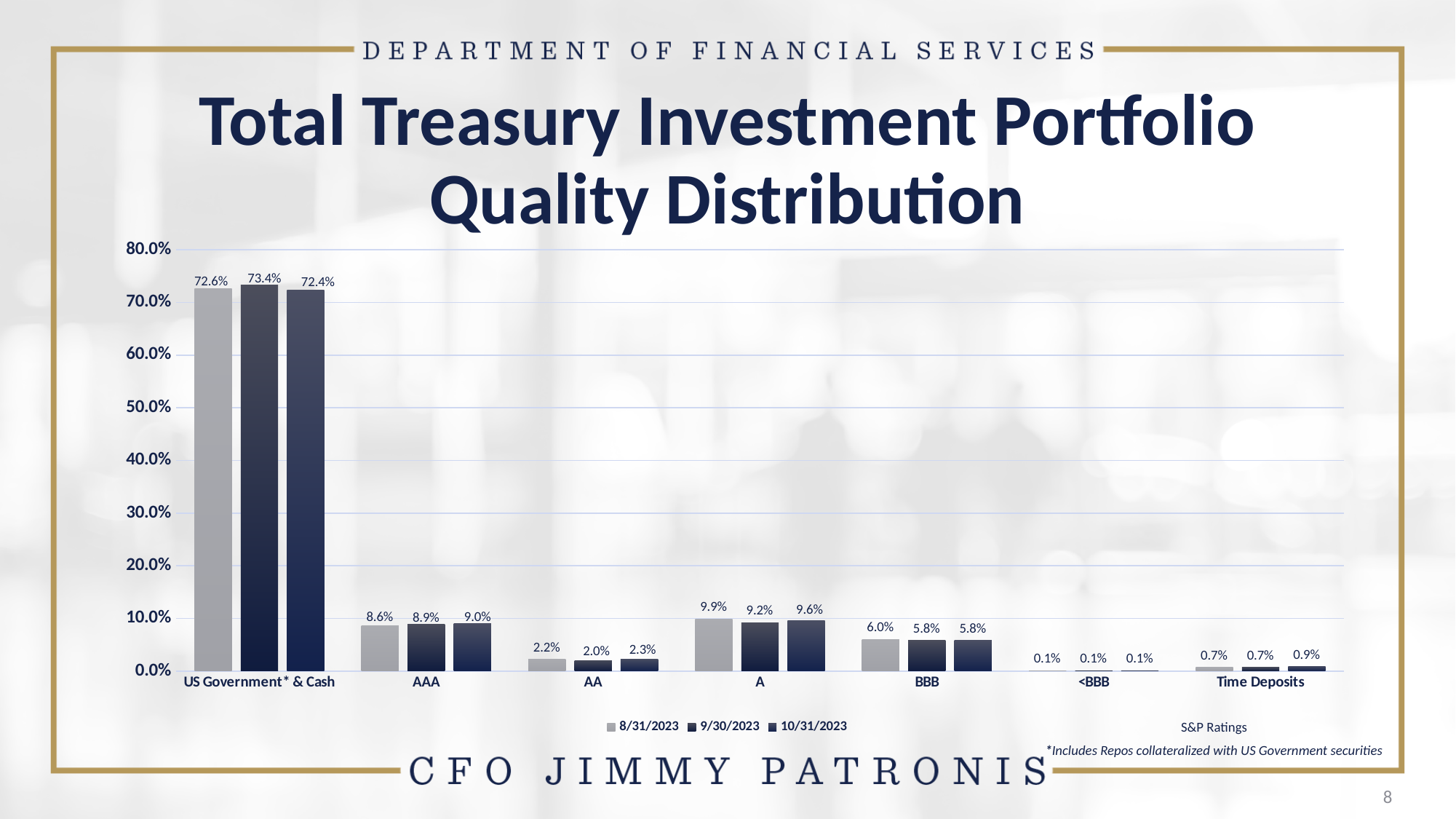
What is the value for Time Deposits for the 10/31/2023 series? 0.9% What is the value for A for the 8/31/2023 series? 9.9% Which category has the lowest value for the 8/31/2023 series? <BBB What is the difference between the 9/30/2023 and 10/31/2023 values for US Government* & Cash? 1.0% What is the value for US Government* & Cash for the 9/30/2023 series? 73.4% What is the value for AAA for the 10/31/2023 series? 9.0% Which is larger for the 8/31/2023 series: the value for AAA or the value for A? A How many series does the legend list? 3 What kind of chart is shown on the slide? bar chart How many categories are shown on the x axis? 7 Which category has the highest value for the 10/31/2023 series? US Government* & Cash Is the value for BBB for the 8/31/2023 series greater or less than 10.0%? less